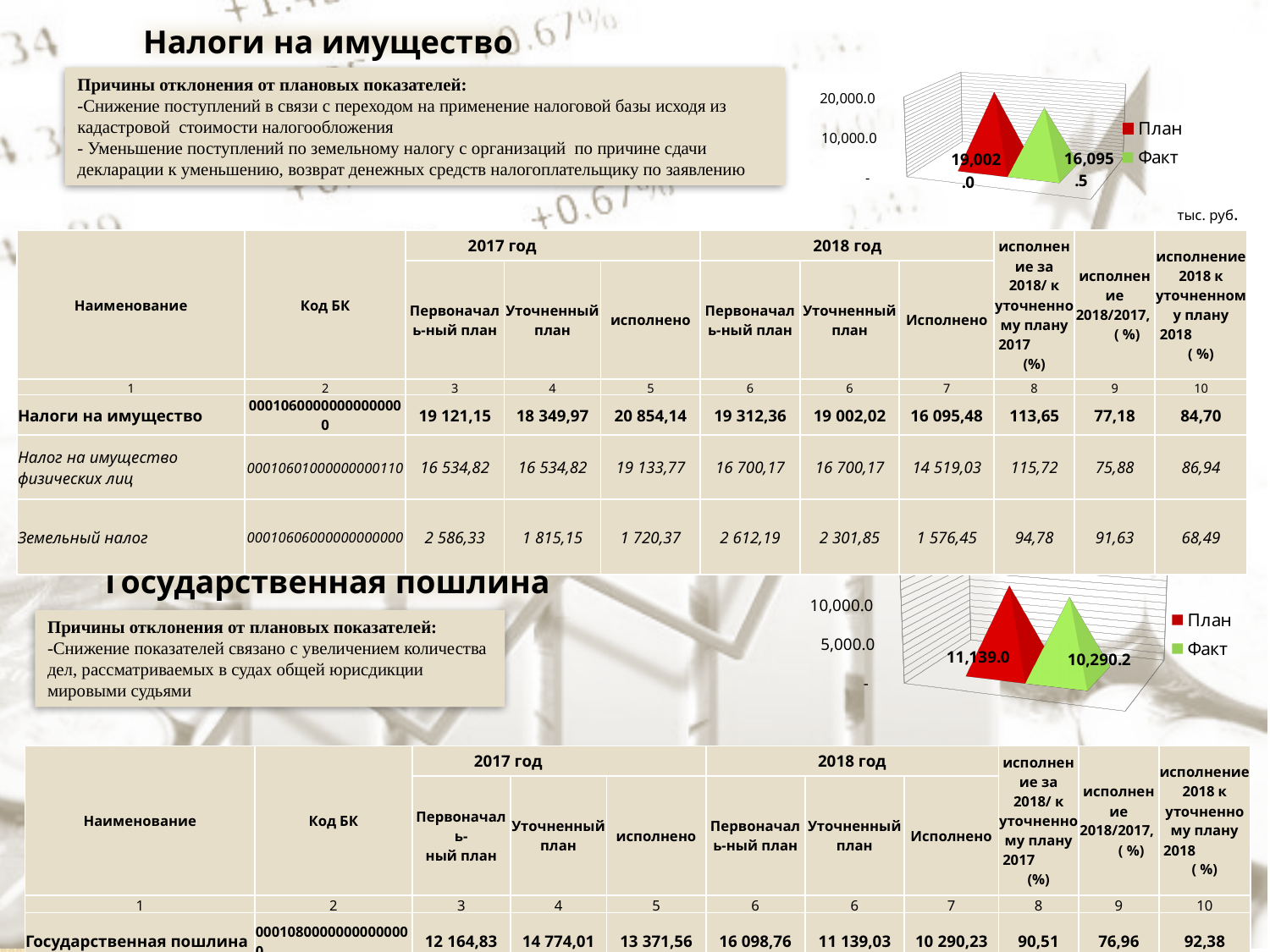
In the top-right chart (Налоги на имущество), what is the difference between План and Факт? 2,906.5 In the bottom chart (Государственная пошлина), which series has the lower value? Факт In the bottom chart (Государственная пошлина), what is the difference between План and Факт? 848.8 In the bottom chart (Государственная пошлина), what colour represents the Факт series? Green In the top-right chart (Налоги на имущество), which series has the higher value, План or Факт? План In the top-right chart (Налоги на имущество), what is the value for План? 19,002.0 In the bottom chart (Государственная пошлина), what is the value for Факт? 10,290.2 How many series does the legend of the top-right chart (Налоги на имущество) list? 2 In the top-right chart (Налоги на имущество), what is the value for Факт? 16,095.5 In the bottom chart (Государственная пошлина), what is the value for План? 11,139.0 In the bottom chart (Государственная пошлина), is the value for План greater or less than 10,000.0? greater In the top-right chart (Налоги на имущество), is the value for Факт greater or less than 20,000.0? less